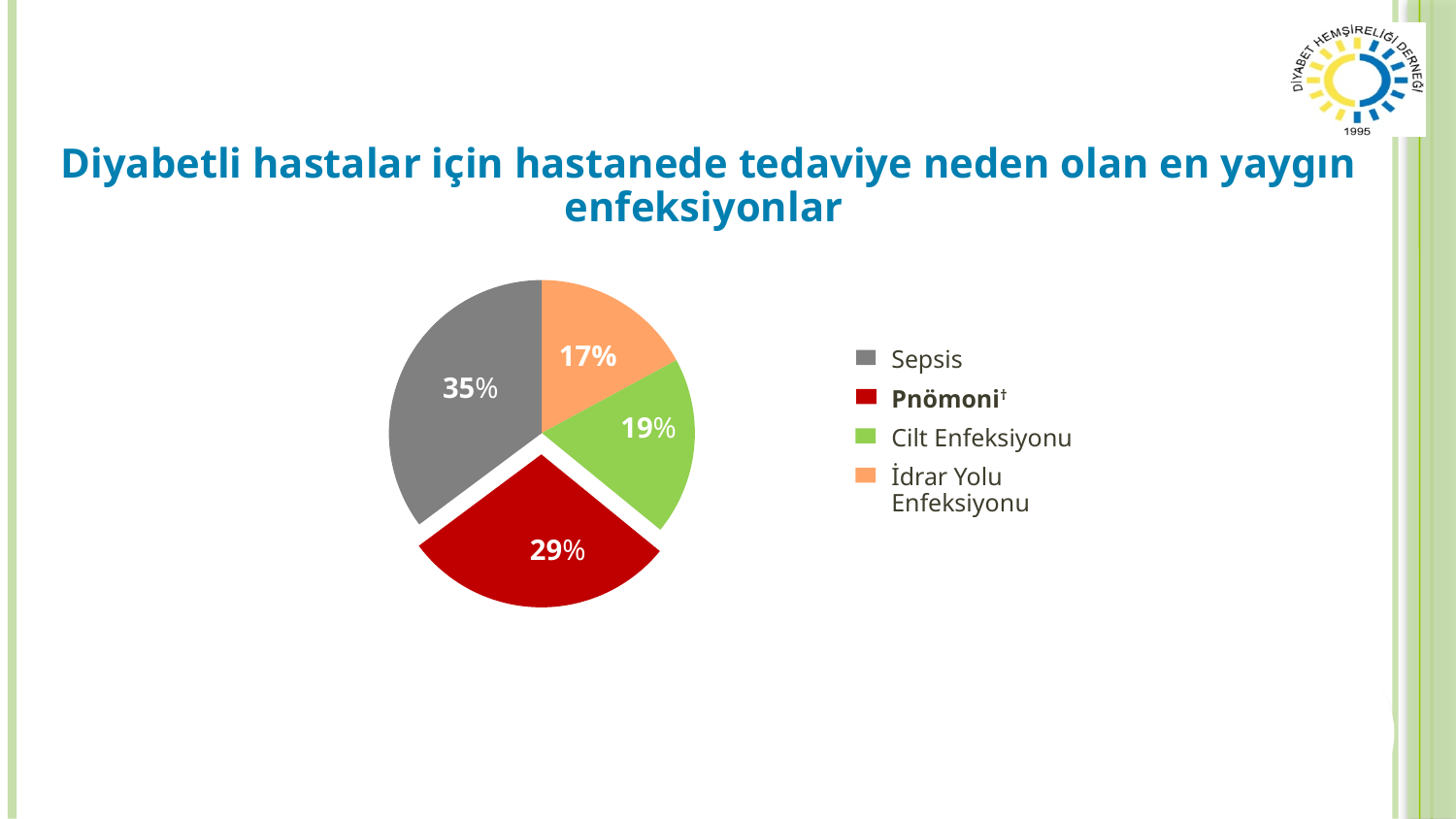
What is the value shown for Cilt Enfeksiyonu? 19% Which category has the smallest slice of the pie? İdrar Yolu Enfeksiyonu Which is larger, the slice for Cilt Enfeksiyonu or the slice for İdrar Yolu Enfeksiyonu? Cilt Enfeksiyonu What is the value shown for İdrar Yolu Enfeksiyonu? 17% What colour is the Sepsis slice in the pie chart? grey What kind of chart is shown on the slide? pie chart How many categories does the pie chart show? 4 Which slice of the pie is pulled out (exploded) from the rest? Pnömoni What is the difference in percentage points between Sepsis and Pnömoni? 6 What is the value shown for Pnömoni? 29% What share of the pie does Sepsis account for? 35% Which category has the largest slice of the pie? Sepsis